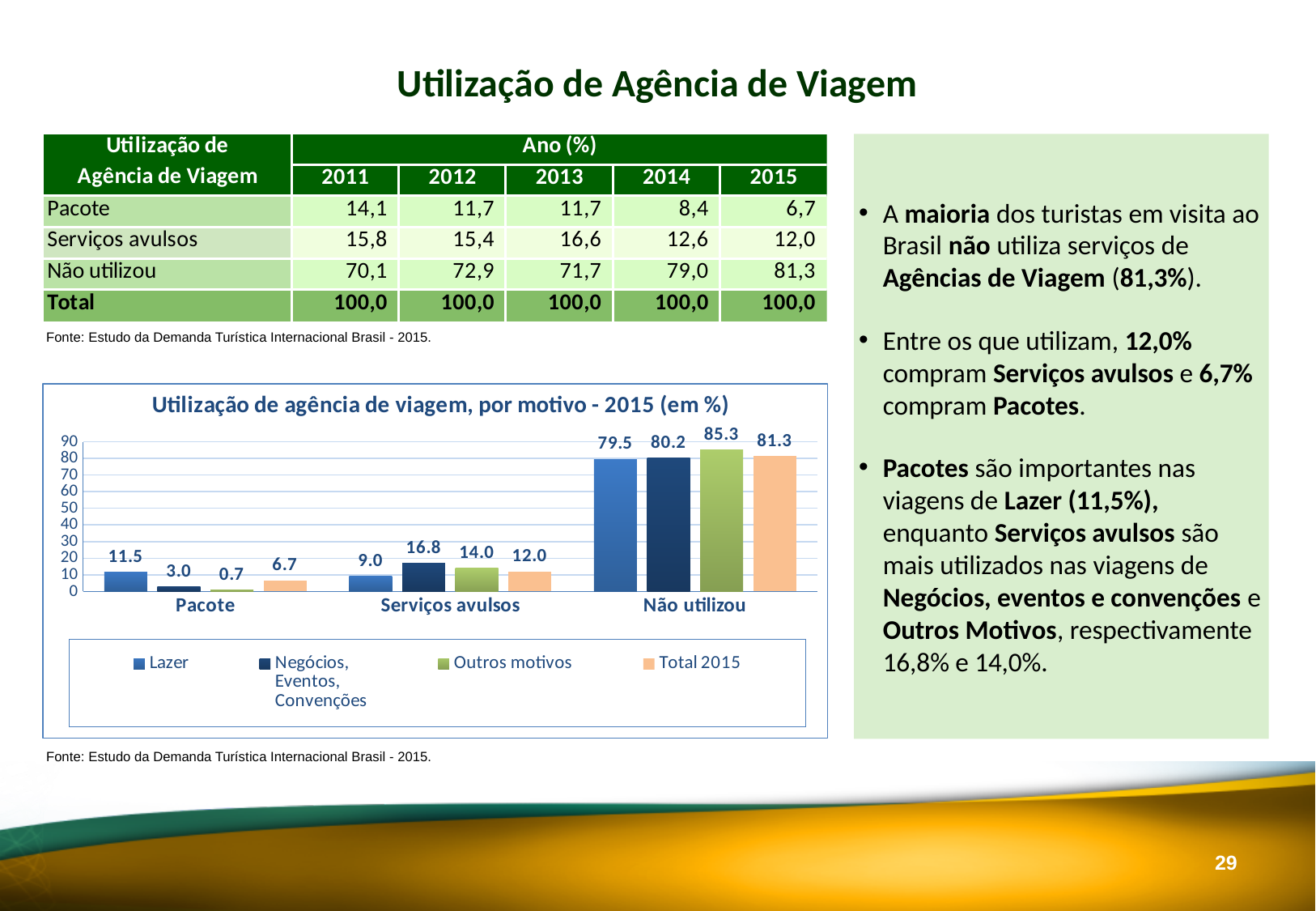
What is the value for Lazer in the Pacote category? 11.5 Which series has the highest value in the Não utilizou category? Outros motivos What type of chart is shown on the slide? bar chart Which series has the lowest value in the Pacote category? Outros motivos Which is larger in the Serviços avulsos category: Lazer or Outros motivos? Outros motivos What is the value for Negócios, Eventos, Convenções in the Serviços avulsos category? 16.8 What is the value for Outros motivos in the Não utilizou category? 85.3 How many series does the legend list? 4 How many categories are shown on the x axis? 3 What is the value for Total 2015 in the Serviços avulsos category? 12.0 What is the difference between the Lazer and Negócios, Eventos, Convenções values in the Pacote category? 8.5 What is the title of the chart? Utilização de agência de viagem, por motivo - 2015 (em %)